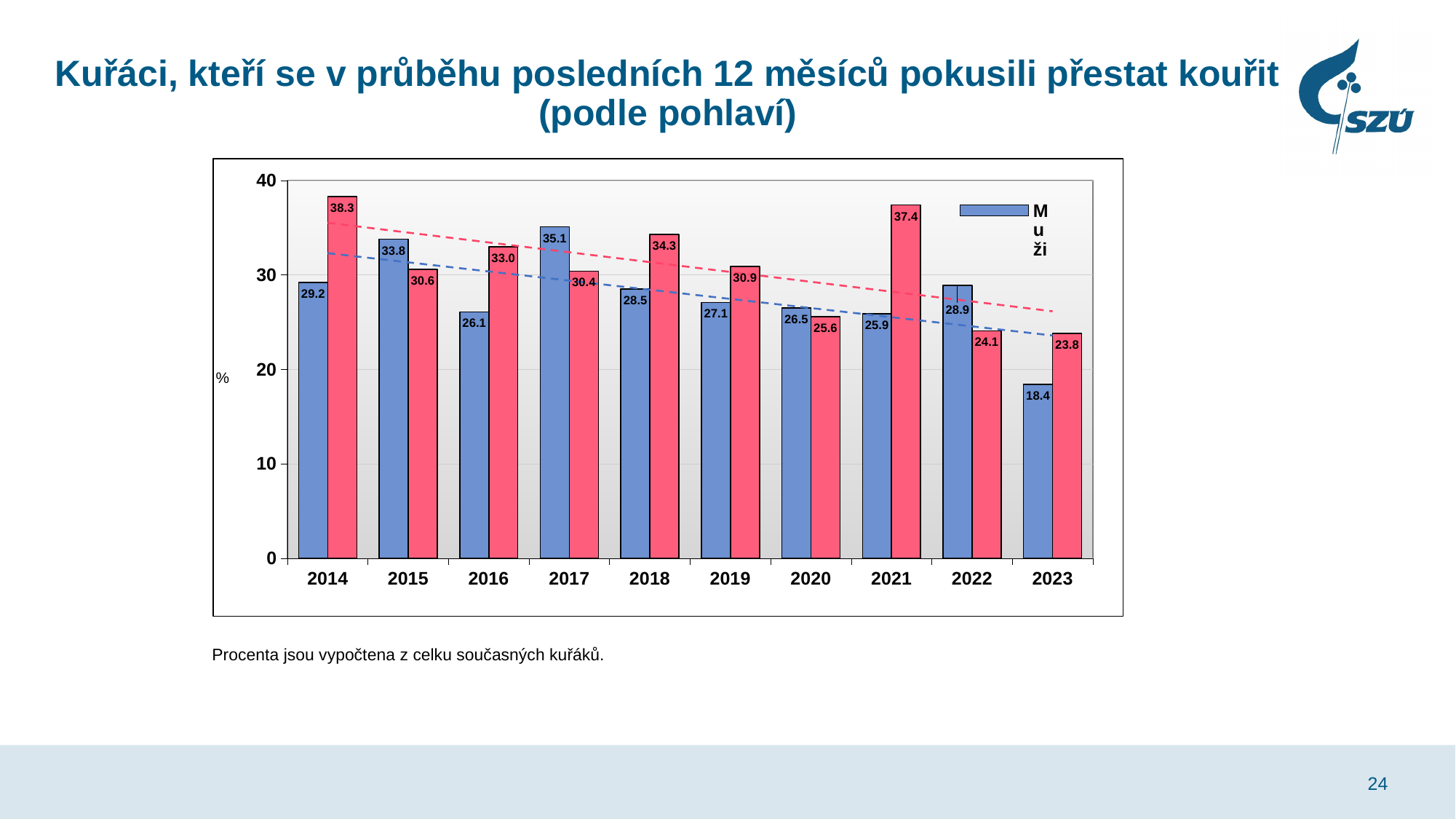
Which is larger in 2020, the Muži bar or the red bar? Muži In which year is the red bar highest? 2014 What is the difference between the red bar and the Muži bar in 2021? 11.5 In which year is the value for Muži lowest? 2023 What is the value of the red bar for 2014? 38.3 What is the unit shown on the y axis of the chart? % What is the value for Muži in 2023? 18.4 What kind of chart is shown on the slide? bar chart What is the value for Muži in 2017? 35.1 How many years are shown on the x axis? 10 In which year is the value for Muži highest? 2017 What is the value of the red bar for 2021? 37.4